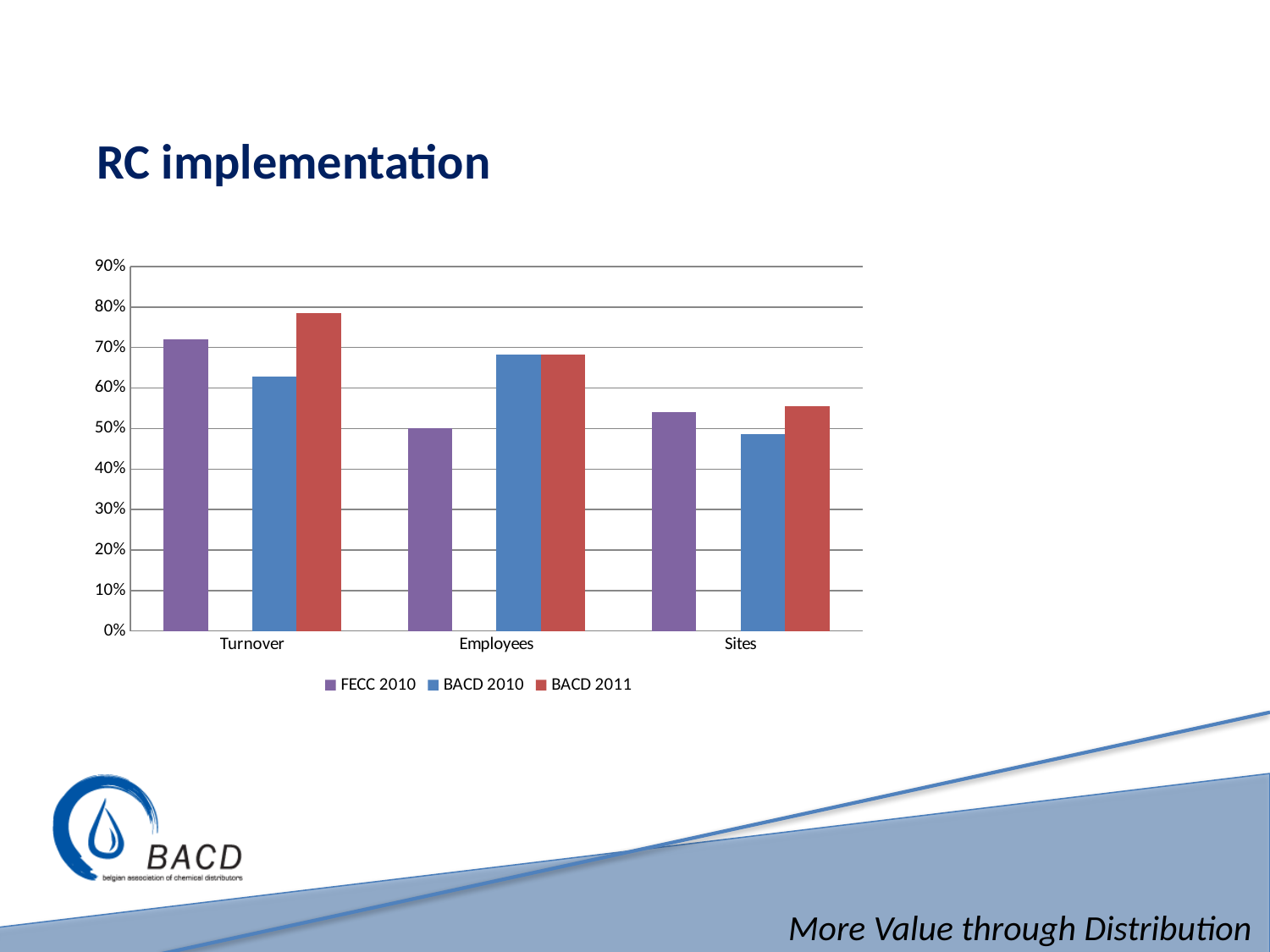
Is the BACD 2011 value for Turnover greater or less than 70%? greater How many categories are shown on the x axis? 3 What is the title of the slide containing the chart? RC implementation Which series has the lowest value for Turnover? BACD 2010 For Sites, which is larger: BACD 2010 or BACD 2011? BACD 2011 Is the BACD 2010 value for Sites greater or less than 50%? less What kind of chart is shown on the slide? bar chart Is the BACD 2010 value for Employees greater or less than 60%? greater Which series has the highest value for Turnover? BACD 2011 How many series does the legend list? 3 Which category and series combination has the highest bar in the chart? BACD 2011 for Turnover For Turnover, which is larger: FECC 2010 or BACD 2010? FECC 2010